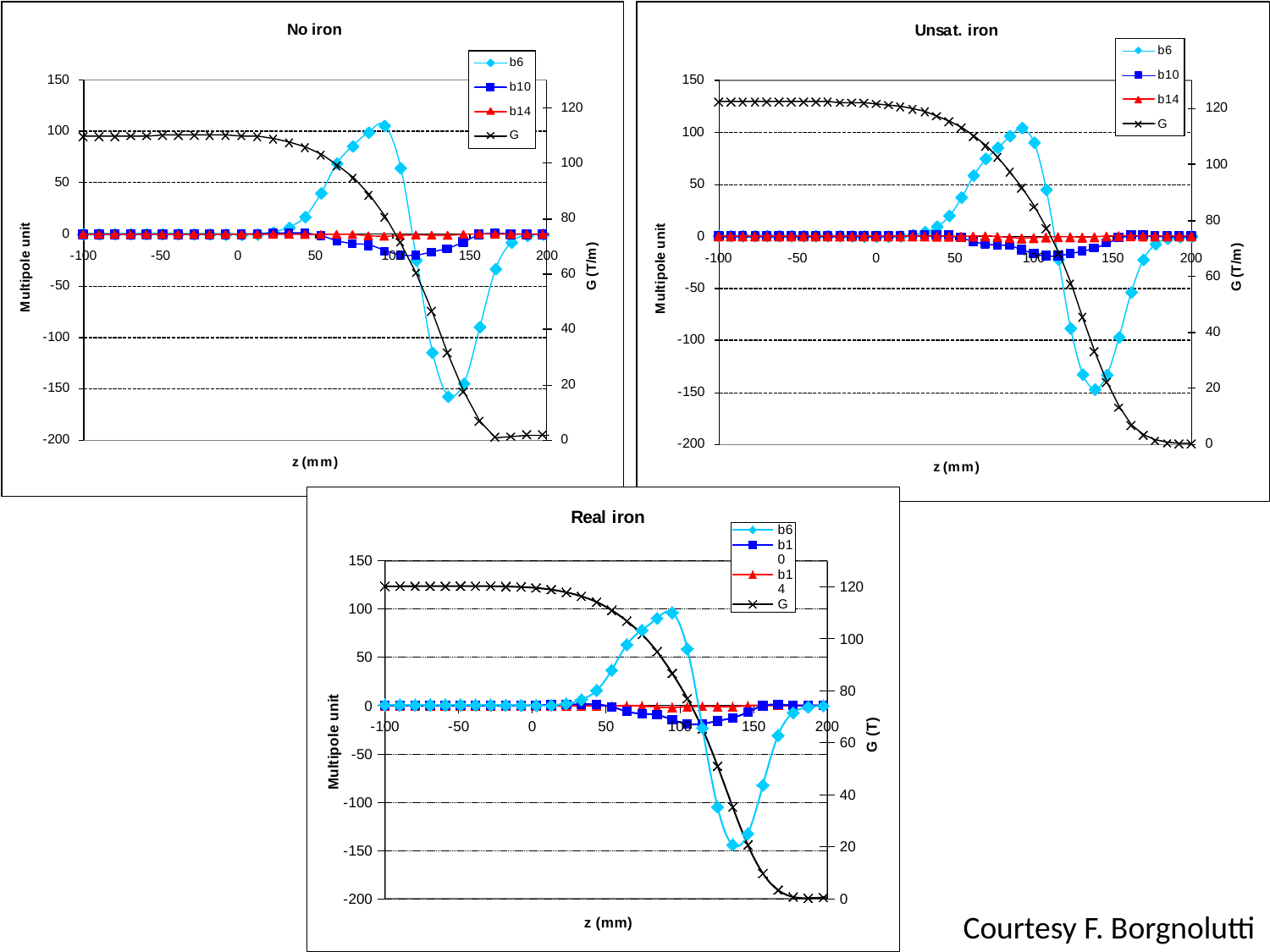
In the "Real iron" chart, is the value of G at z = 200 mm greater or less than 20 T? less In the "No iron" chart, does G rise or fall as z increases from 0 mm to 200 mm? fall In the "Unsat. iron" chart, is the value of G at z = -100 mm greater or less than 100 T/m? greater What are the legend entries of the "No iron" chart? b6, b10, b14, G How many series does the legend of the "Unsat. iron" chart list? 4 In the "Real iron" chart, is the value of b6 at z = 0 mm greater or less than 50 multipole units? less In the "No iron" chart, at z = 150 mm, which series has the larger value, b6 or b10? b10 What kind of chart is the "No iron" chart? line chart What is the label of the right-hand vertical axis on the "Real iron" chart? G (T)